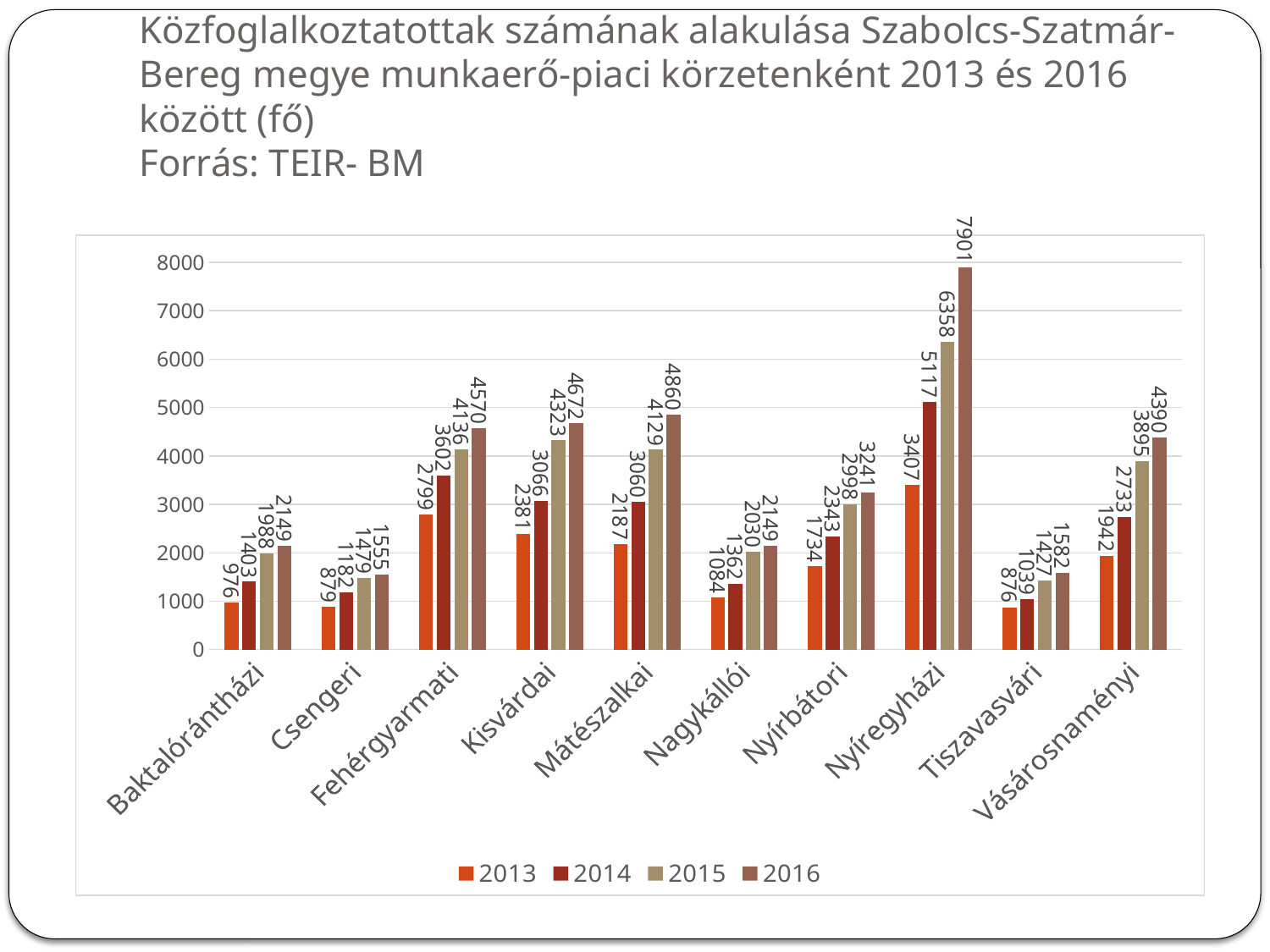
What was the value for Nyíregyházi in 2016? 7901 What is the difference between the 2016 and 2013 values for Nyíregyházi? 4494 How many districts are shown on the x axis? 10 What kind of chart is shown on the slide? bar chart Which district had the lowest value in 2014? Tiszavasvári For Nyírbátori, do the values rise or fall from 2013 to 2016? rise How many series does the legend list? 4 What was the value for Vásárosnaményi in 2015? 3895 Which is larger: the 2016 value for Kisvárdai or the 2016 value for Mátészalkai? Mátészalkai Is the 2015 value for Fehérgyarmati greater or less than 4000? greater Which district had the highest value in 2016? Nyíregyházi What was the value for Csengeri in 2013? 879